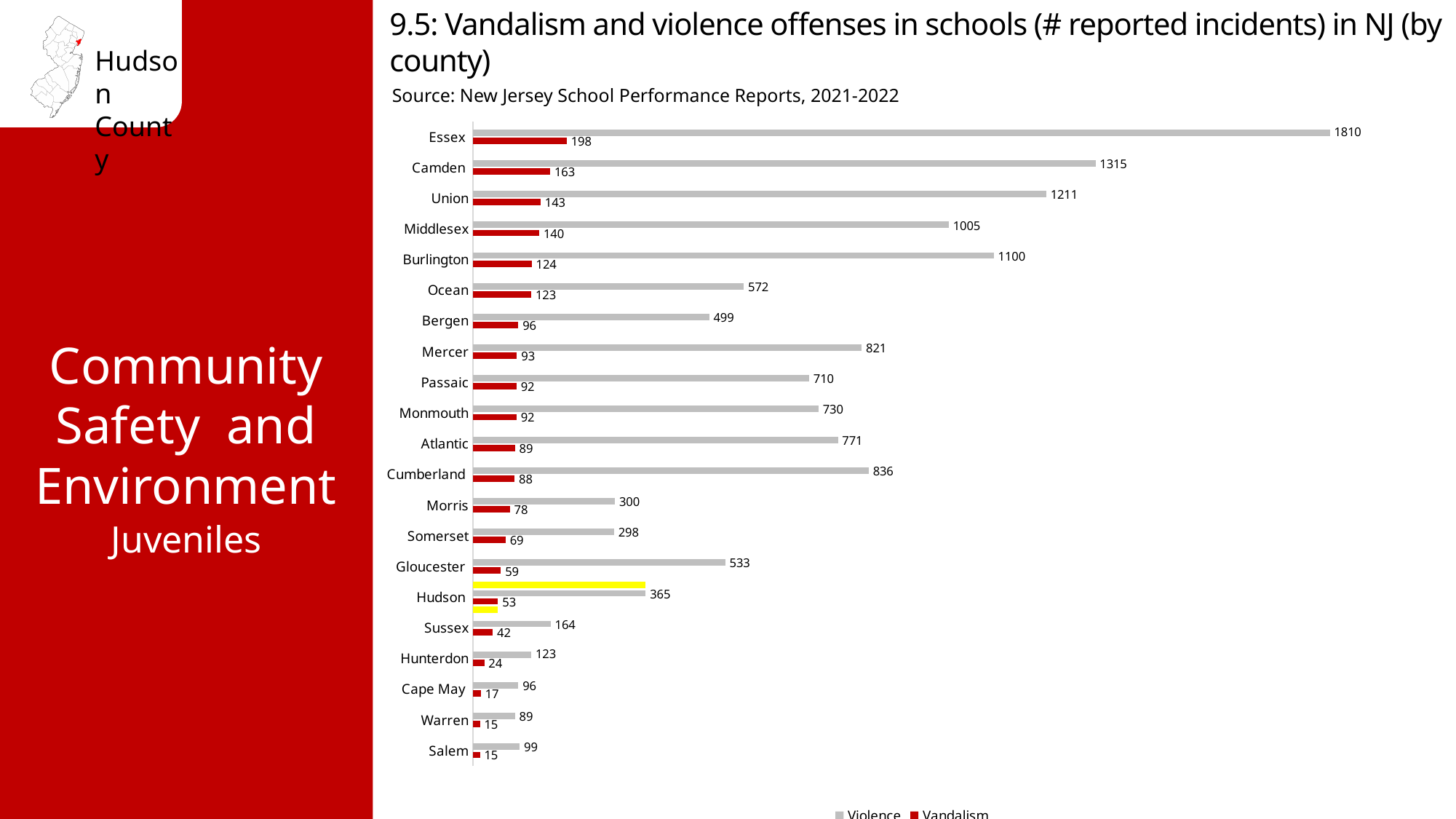
What is the number of vandalism incidents for Cumberland County? 88 Which series is shown in red in the chart? Vandalism What is the difference between the violence incidents in Essex and Camden? 495 What is the difference between violence and vandalism incidents in Hudson County? 312 Which county has the lowest number of violence incidents? Warren What is the number of reported violence incidents for Hudson County? 365 What type of chart is shown on the slide? bar chart How many counties are shown in the chart? 21 How many series does the legend list? 2 Which county has the highest number of violence incidents? Essex What is the number of reported vandalism incidents for Hudson County? 53 Which county has more violence incidents, Burlington or Middlesex? Burlington